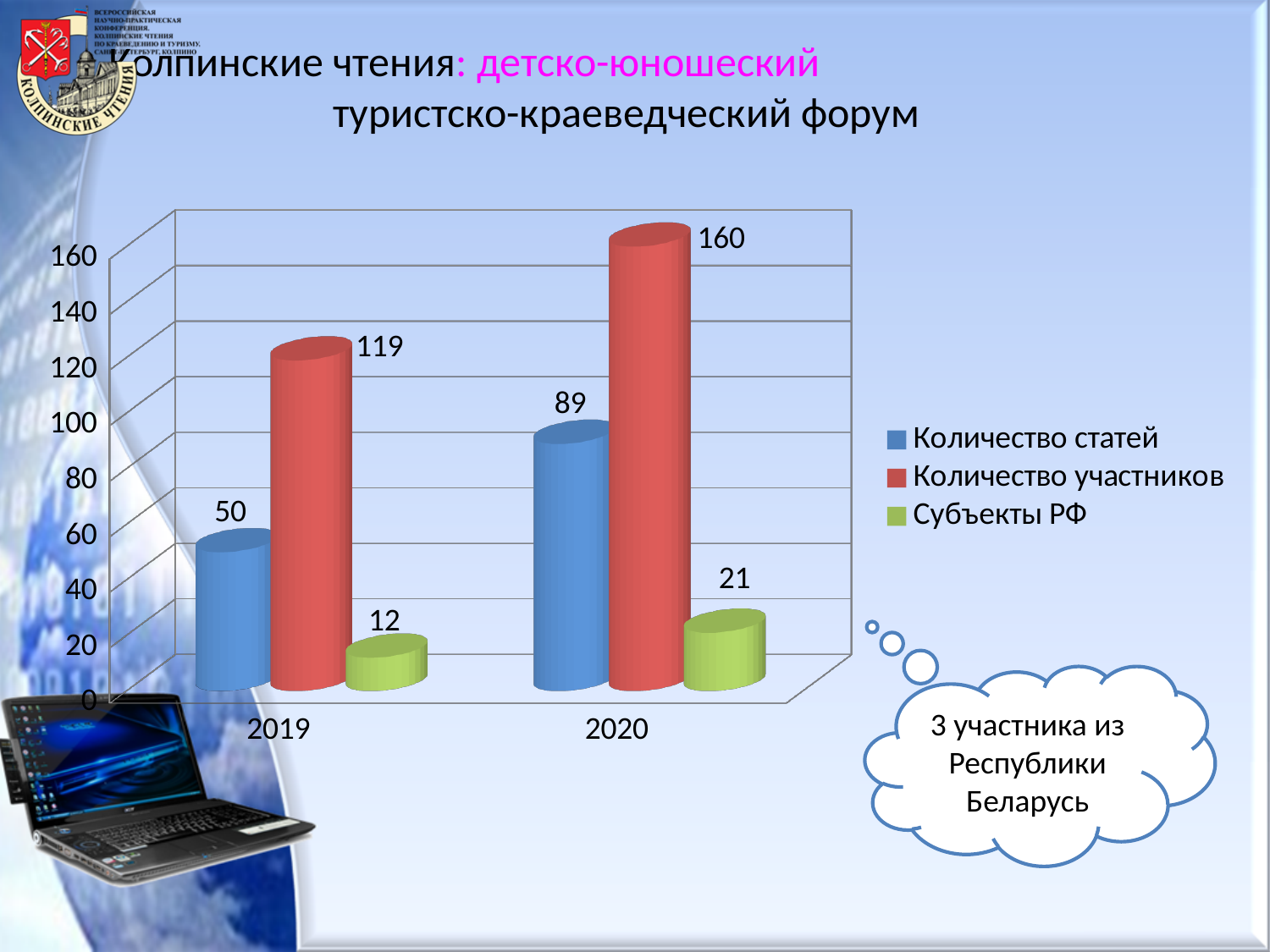
What is the value of Количество участников for 2019? 119 What is the value of Количество статей for 2019? 50 What kind of chart is shown on the slide? Bar chart Which year has the higher value for Количество статей? 2020 How many series does the legend list? 3 What is the value of Субъекты РФ for 2020? 21 What is the difference between Количество участников in 2020 and in 2019? 41 What is the difference between Количество статей in 2020 and in 2019? 39 Which series has the lowest value in 2019? Субъекты РФ Does the value of Субъекты РФ rise or fall from 2019 to 2020? Rise How many years are shown on the x axis? 2 What is the value of Количество участников for 2020? 160